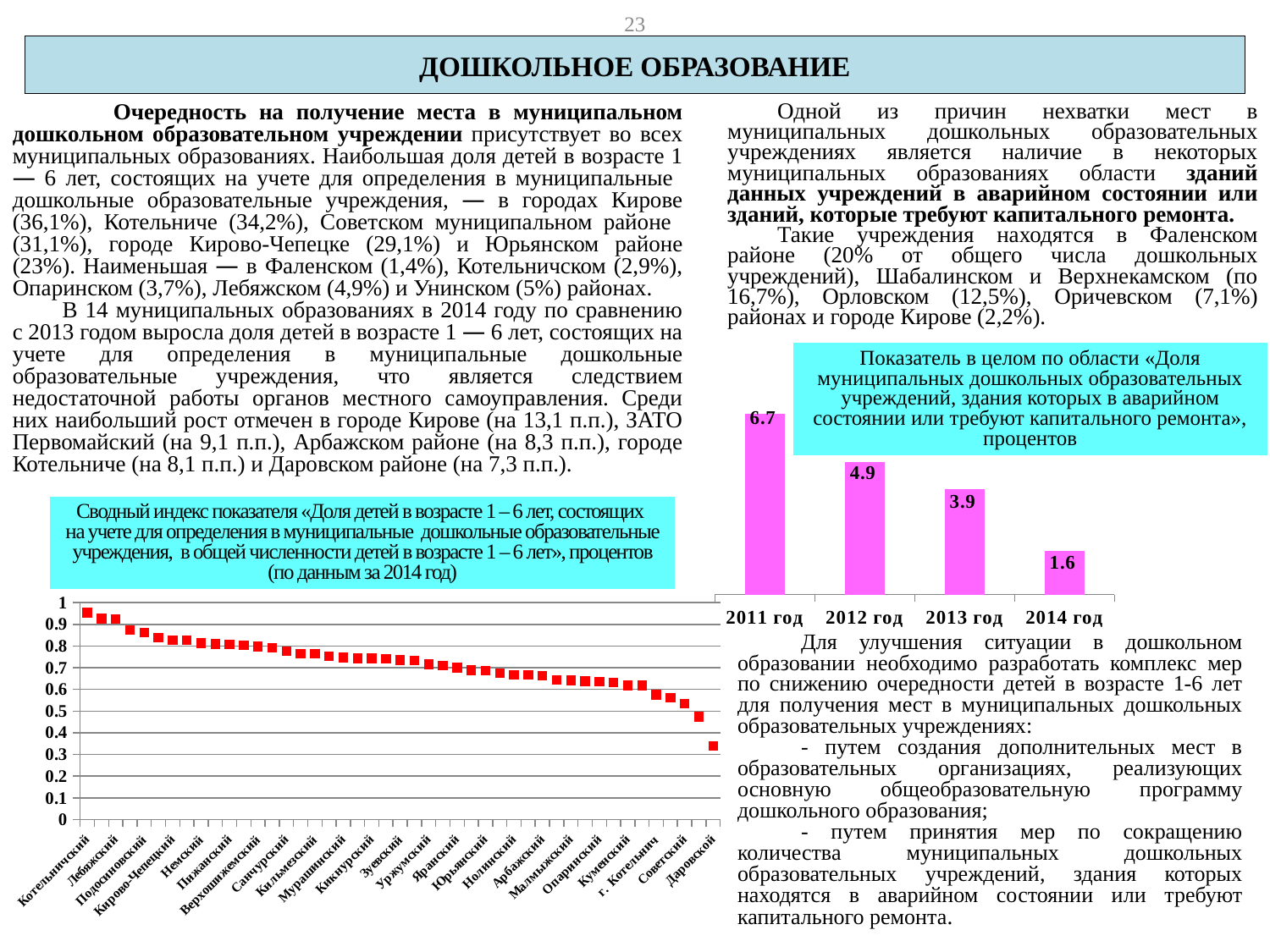
On the dot chart at the bottom left, is the value for Даровской greater or less than 0.4? less On the bar chart on the right, which year has the lowest value? 2014 год On the bar chart on the right, what is the value for 2014 год? 1.6 On the bar chart on the right, how many years are shown? 4 On the bar chart on the right, which year has the highest value? 2011 год What kind of chart is the chart on the right showing values by year? bar chart On the bar chart on the right, what is the value for 2011 год? 6.7 On the bar chart on the right, what is the value for 2013 год? 3.9 On the bar chart on the right, do the values rise or fall from 2011 to 2014? fall On the bar chart on the right, what is the difference between the values for 2011 год and 2014 год? 5.1 On the dot chart at the bottom left, is the value for Котельничский greater or less than 0.9? greater On the bar chart on the right, which is larger, the value for 2012 год or 2013 год? 2012 год